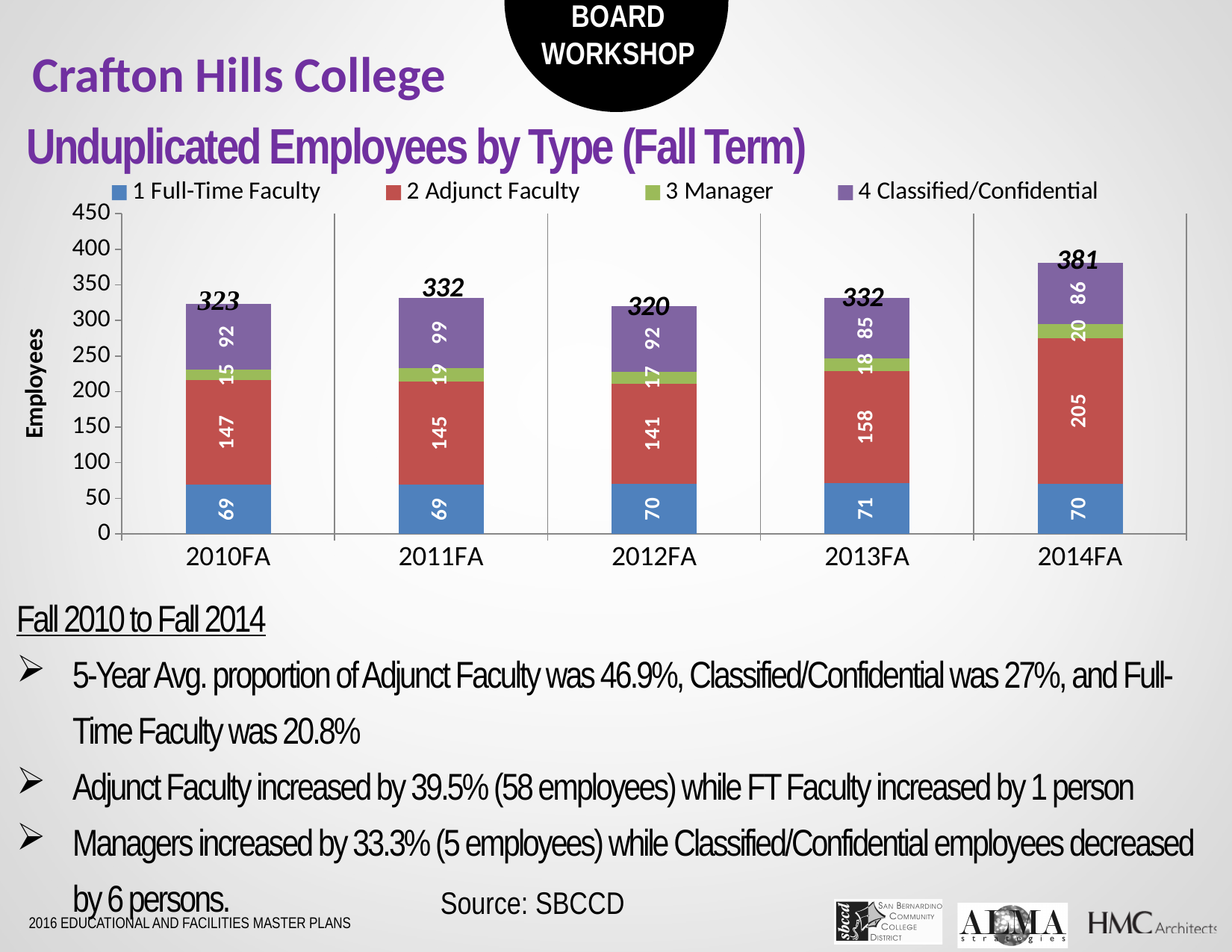
Which is larger, the 4 Classified/Confidential value in 2011FA or in 2014FA? 2011FA What is the value for 1 Full-Time Faculty in 2013FA? 71 What is the value for 4 Classified/Confidential in 2011FA? 99 How many series does the legend list? 4 What is the value for 2 Adjunct Faculty in 2014FA? 205 What is the value for 3 Manager in 2012FA? 17 What is the total of the stacked bar for 2014FA? 381 What is the difference between the 2 Adjunct Faculty values in 2014FA and 2010FA? 58 How many fall terms are shown on the x axis? 5 Which fall term has the highest total number of employees? 2014FA What kind of chart is shown on the slide? Stacked bar chart Which fall term has the lowest total number of employees? 2012FA